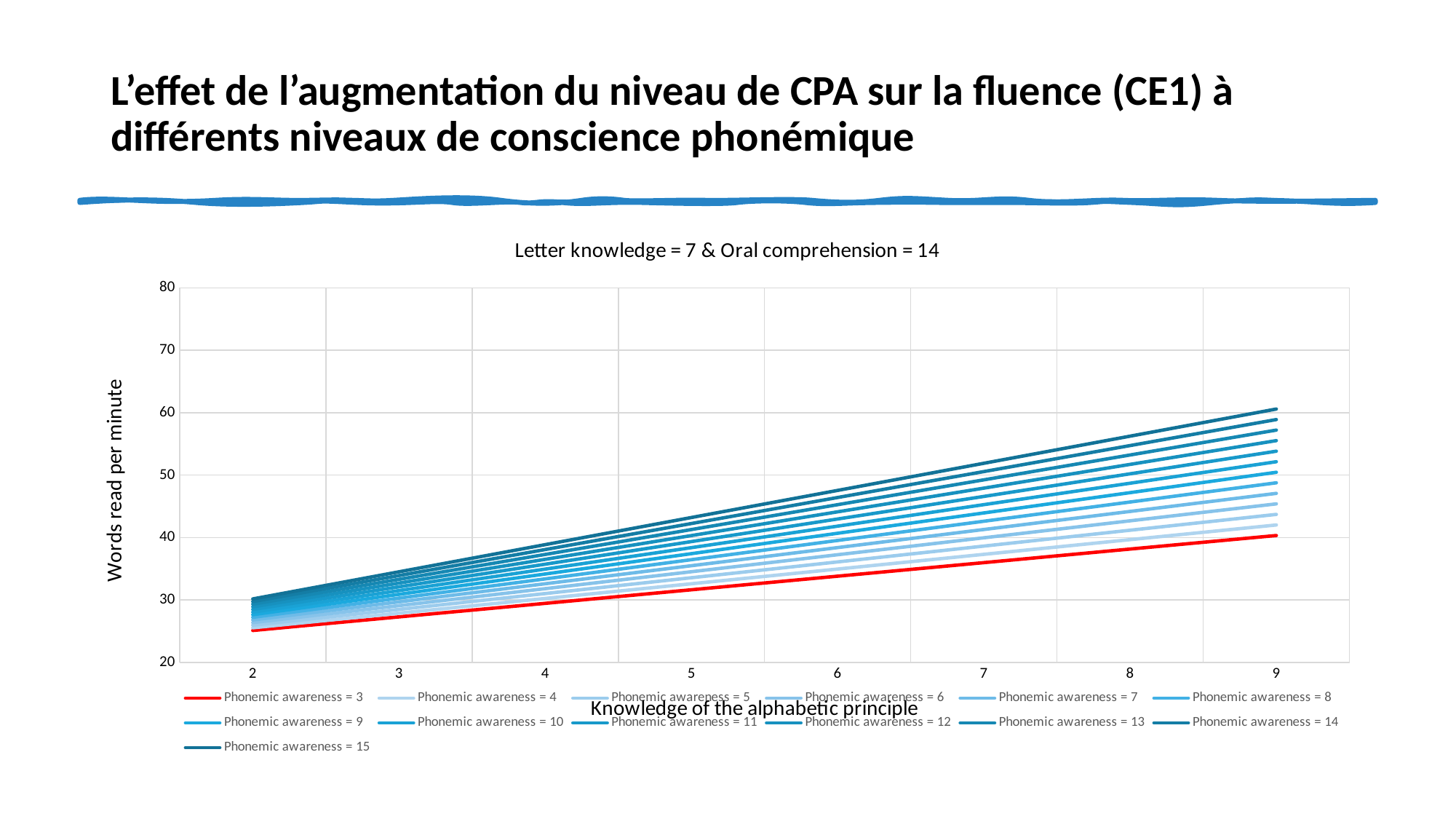
How many series does the legend list? 13 Which series has the lowest value at Knowledge of the alphabetic principle = 9? Phonemic awareness = 3 At Knowledge of the alphabetic principle = 9, which is larger: the value for Phonemic awareness = 15 or for Phonemic awareness = 3? Phonemic awareness = 15 Is the value for Phonemic awareness = 15 at Knowledge of the alphabetic principle = 2 greater or less than 40? less How many points are on the x axis (Knowledge of the alphabetic principle)? 8 What is the title of the chart? Letter knowledge = 7 & Oral comprehension = 14 Do the values for Phonemic awareness = 3 rise or fall as Knowledge of the alphabetic principle increases from 2 to 9? Rise What kind of chart is shown on the slide? Line chart Is the value for Phonemic awareness = 3 at Knowledge of the alphabetic principle = 2 greater or less than 30? less Which series has the highest value at Knowledge of the alphabetic principle = 9? Phonemic awareness = 15 What is the label of the y axis? Words read per minute Is the value for Phonemic awareness = 15 at Knowledge of the alphabetic principle = 9 greater or less than 50? greater